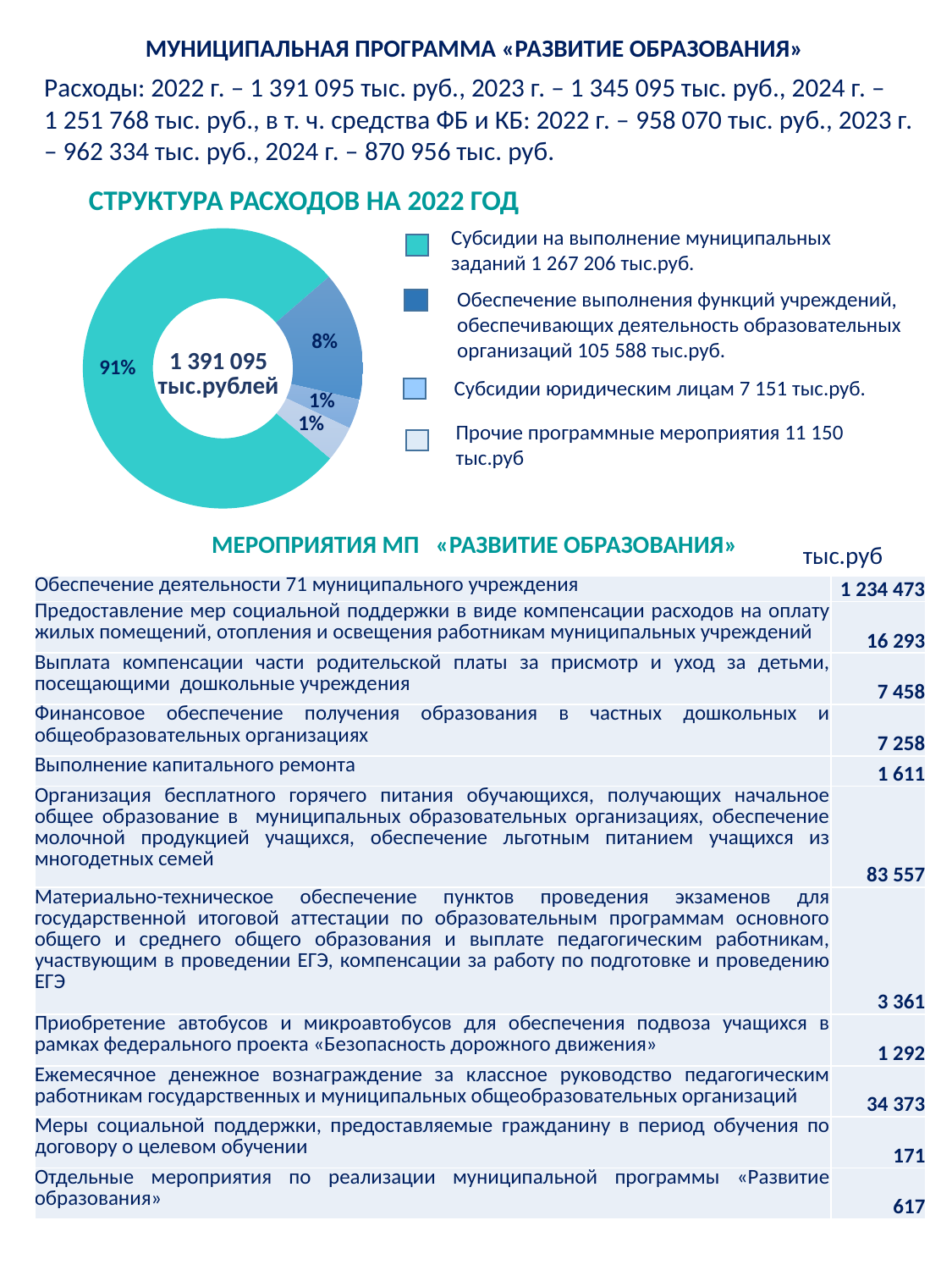
In the pie chart, what is the difference between the legend values for «Субсидии на выполнение муниципальных заданий» and «Обеспечение выполнения функций учреждений»? 1 161 618 тыс.руб. What share of the pie chart is taken by «Обеспечение выполнения функций учреждений, обеспечивающих деятельность образовательных организаций»? 8% According to the legend of the pie chart, what is the value for «Прочие программные мероприятия»? 11 150 тыс.руб What total value is printed in the centre of the pie chart? 1 391 095 тыс.рублей Based on the legend values, which category is the smallest in the pie chart «СТРУКТУРА РАСХОДОВ НА 2022 ГОД»? Субсидии юридическим лицам Which category is the largest in the pie chart «СТРУКТУРА РАСХОДОВ НА 2022 ГОД»? Субсидии на выполнение муниципальных заданий According to the legend of the pie chart, what is the value for «Субсидии юридическим лицам»? 7 151 тыс.руб. According to the legend of the pie chart, what is the value for «Субсидии на выполнение муниципальных заданий»? 1 267 206 тыс.руб. What share of the pie chart is taken by «Субсидии на выполнение муниципальных заданий»? 91% How many slices does the pie chart «СТРУКТУРА РАСХОДОВ НА 2022 ГОД» have? 4 What kind of chart is shown under the heading «СТРУКТУРА РАСХОДОВ НА 2022 ГОД»? Pie (donut) chart In the pie chart, which is larger: the share for «Обеспечение выполнения функций учреждений» or the share for «Субсидии юридическим лицам»? Обеспечение выполнения функций учреждений